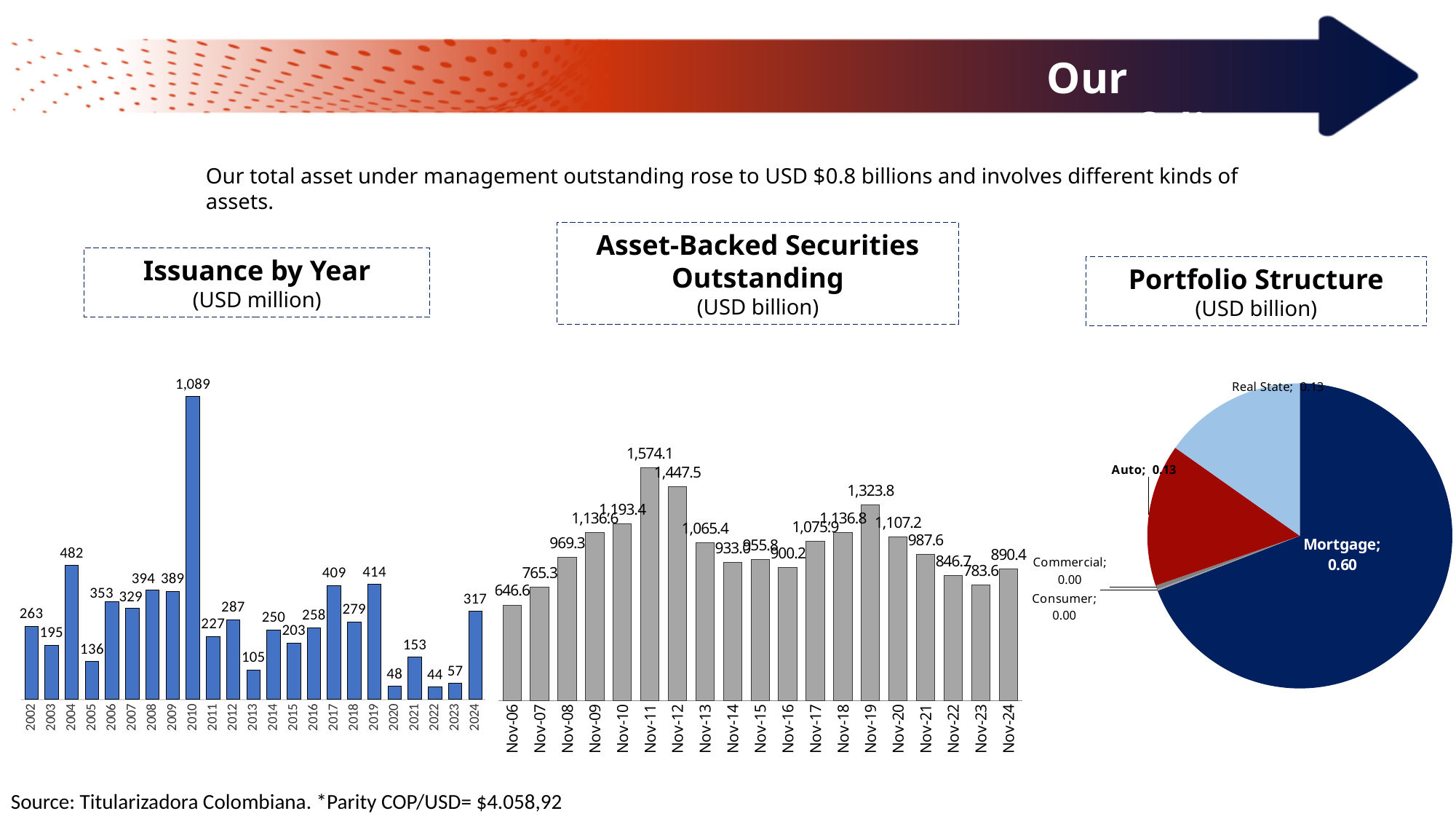
In the Asset-Backed Securities Outstanding chart, which is larger, the value for Nov-12 or Nov-19? Nov-12 In the Asset-Backed Securities Outstanding chart, which period has the highest value? Nov-11 What kind of chart is the Asset-Backed Securities Outstanding chart? Bar chart In the Issuance by Year chart, which year had the lowest issuance? 2022 In the Asset-Backed Securities Outstanding chart, which period has the lowest value? Nov-06 In the Issuance by Year chart, how much higher was issuance in 2024 than in 2023? 260 In the Issuance by Year chart, what was the issuance in 2010? 1,089 In the Issuance by Year chart, how many years are shown? 23 In the Portfolio Structure chart, what is the value for Mortgage? 0.60 In the Issuance by Year chart, which year had the highest issuance? 2010 In the Portfolio Structure chart, how many categories are labelled? 5 In the Asset-Backed Securities Outstanding chart, what is the value for Nov-24? 890.4